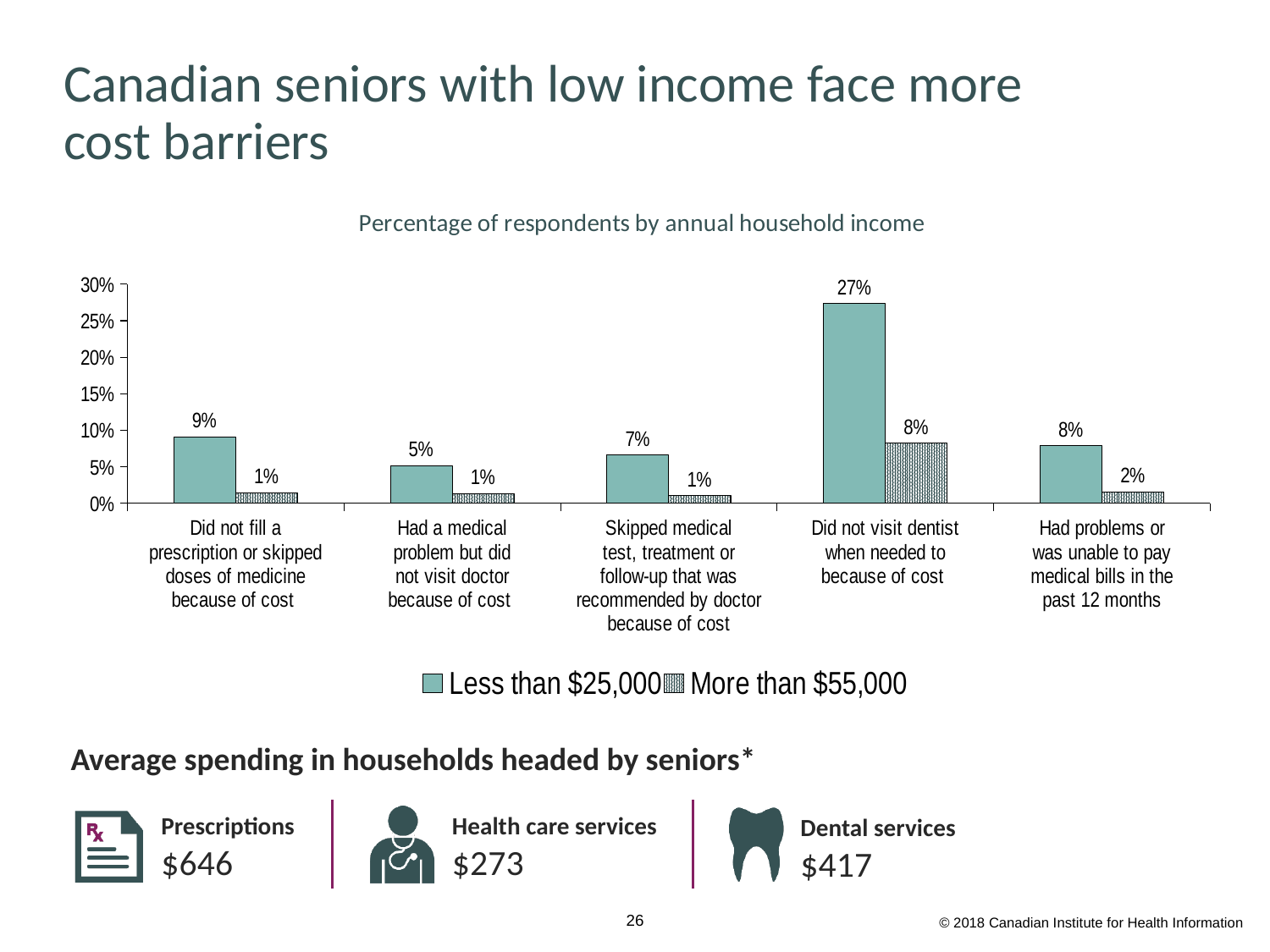
What is the difference between the 'Less than $25,000' and 'More than $55,000' values for 'Did not visit dentist when needed to because of cost'? 19% Is the 'Less than $25,000' value for 'Did not visit dentist when needed to because of cost' greater or less than 25%? greater Which category has the lowest value for the 'Less than $25,000' series? Had a medical problem but did not visit doctor because of cost Which category has the highest value for the 'Less than $25,000' series? Did not visit dentist when needed to because of cost For 'Skipped medical test, treatment or follow-up that was recommended by doctor because of cost', which income group has the larger value? Less than $25,000 What percentage of respondents with household income less than $25,000 did not visit a dentist when needed because of cost? 27% What kind of chart is shown on the slide? Bar chart What percentage of respondents with household income more than $55,000 had problems or were unable to pay medical bills in the past 12 months? 2% How many categories are shown on the x axis of the chart? 5 What is the title of the chart? Percentage of respondents by annual household income How many series does the chart legend list? 2 What percentage of respondents with household income less than $25,000 did not fill a prescription or skipped doses of medicine because of cost? 9%